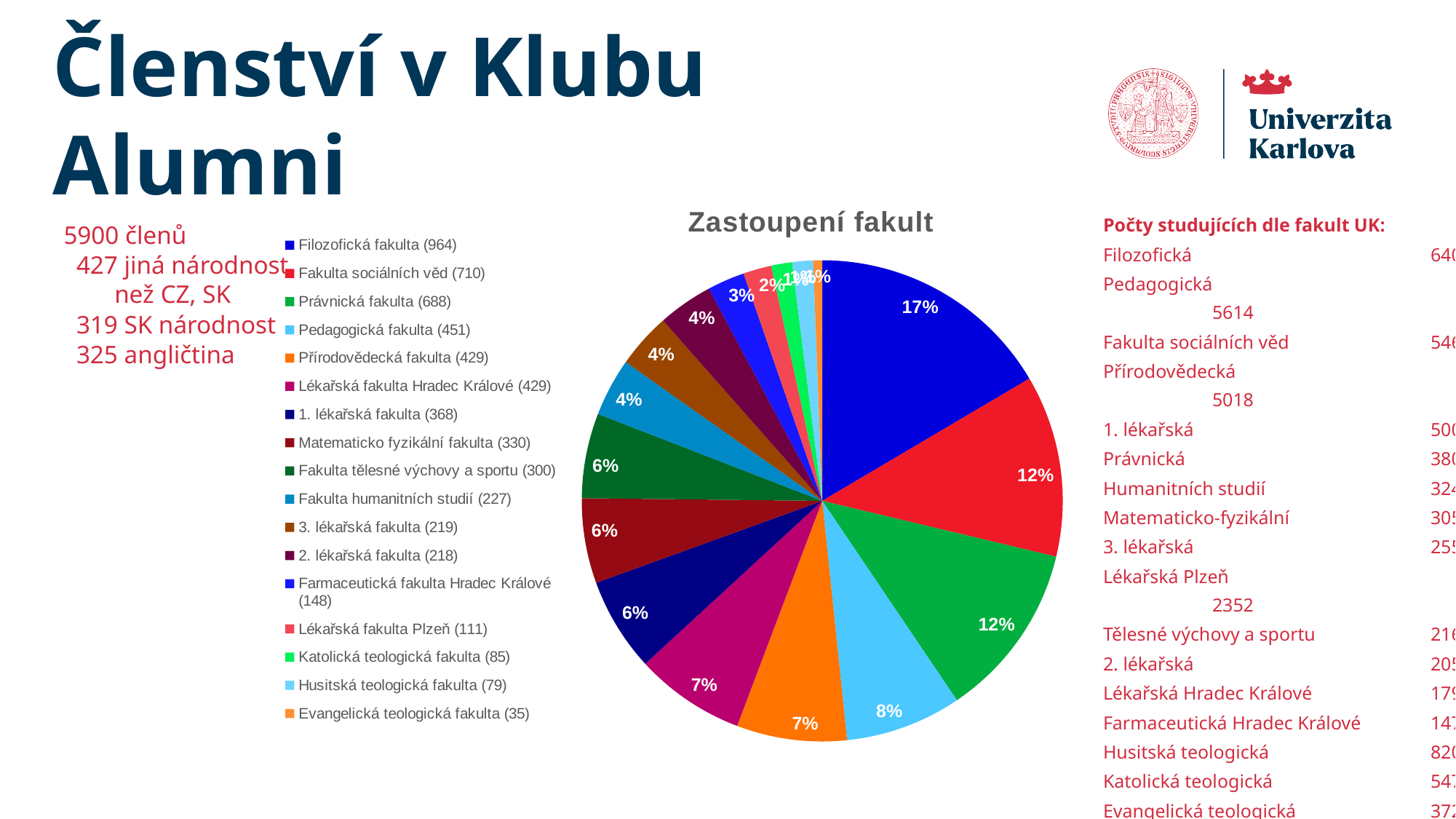
According to the legend, how many members does Fakulta humanitních studií have? 227 What kind of chart is shown under the title "Zastoupení fakult"? pie chart How many faculties (categories) does the pie chart's legend list? 17 Which faculty has the smallest slice in the pie chart? Evangelická teologická fakulta Which faculty has the largest slice in the pie chart? Filozofická fakulta What is the difference between the member counts of Filozofická fakulta (964) and Fakulta sociálních věd (710)? 254 What share of the pie does Filozofická fakulta represent? 17% Which has more members, Právnická fakulta or Pedagogická fakulta? Právnická fakulta What colour is the slice for Filozofická fakulta in the pie chart? blue What is the title of the pie chart? Zastoupení fakult According to the legend, how many members does Filozofická fakulta have? 964 What share of the pie does Pedagogická fakulta represent? 8%